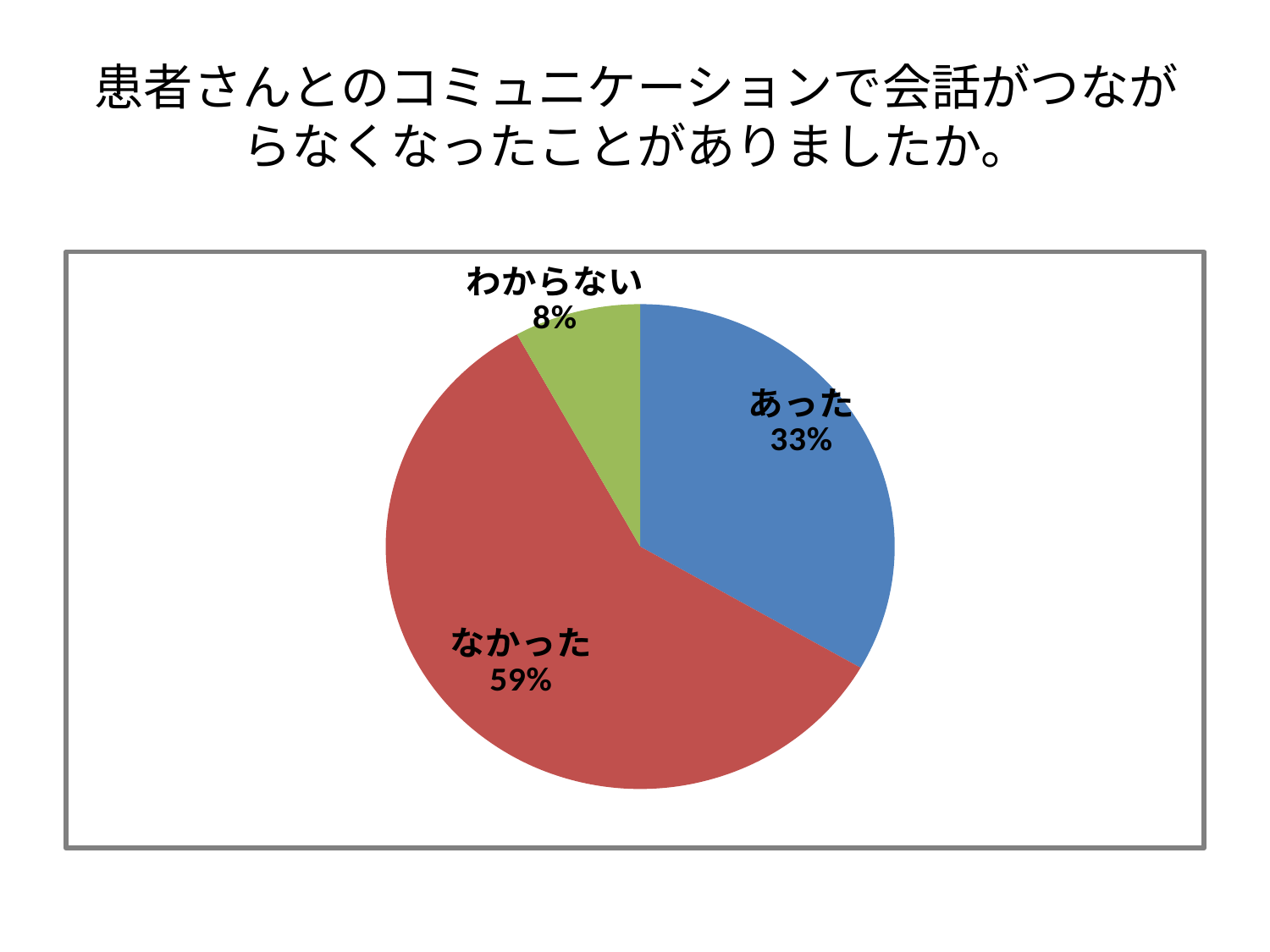
Which category has the largest slice of the pie? なかった How many categories are shown in the pie chart? 3 Which is larger, the slice for あった or the slice for わからない? あった What is the difference in percentage points between なかった and あった? 26 Which category has the smallest slice of the pie? わからない What share of the pie does わからない represent? 8% What kind of chart is shown on the slide? pie chart What colour is the slice for なかった? red What is the difference in percentage points between あった and わからない? 25 What share of the pie does あった represent? 33% What colour is the slice for わからない? green What share of the pie does なかった represent? 59%